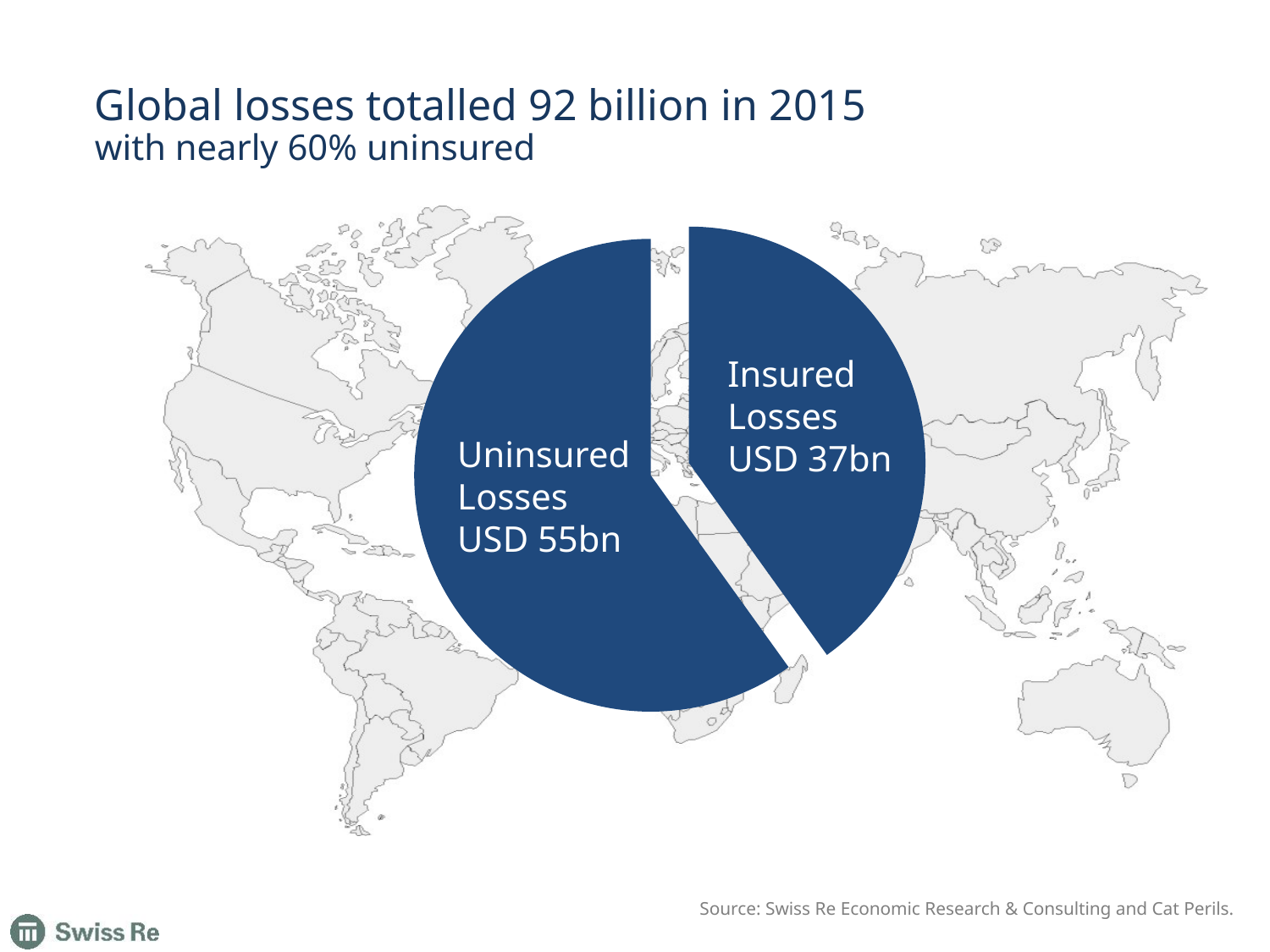
What is the total of the two slices in the pie chart? USD 92bn How many slices does the pie chart have? 2 What is the difference between Uninsured Losses and Insured Losses? USD 18bn Which slice of the pie chart is the largest? Uninsured Losses What kind of chart is shown on the slide? pie chart What is the title of the slide? Global losses totalled 92 billion in 2015 Which slice of the pie chart is the smallest? Insured Losses What is the value shown for Insured Losses? USD 37bn Which is larger, Insured Losses or Uninsured Losses? Uninsured Losses What colour are the slices of the pie chart? dark blue What is the value shown for Uninsured Losses? USD 55bn